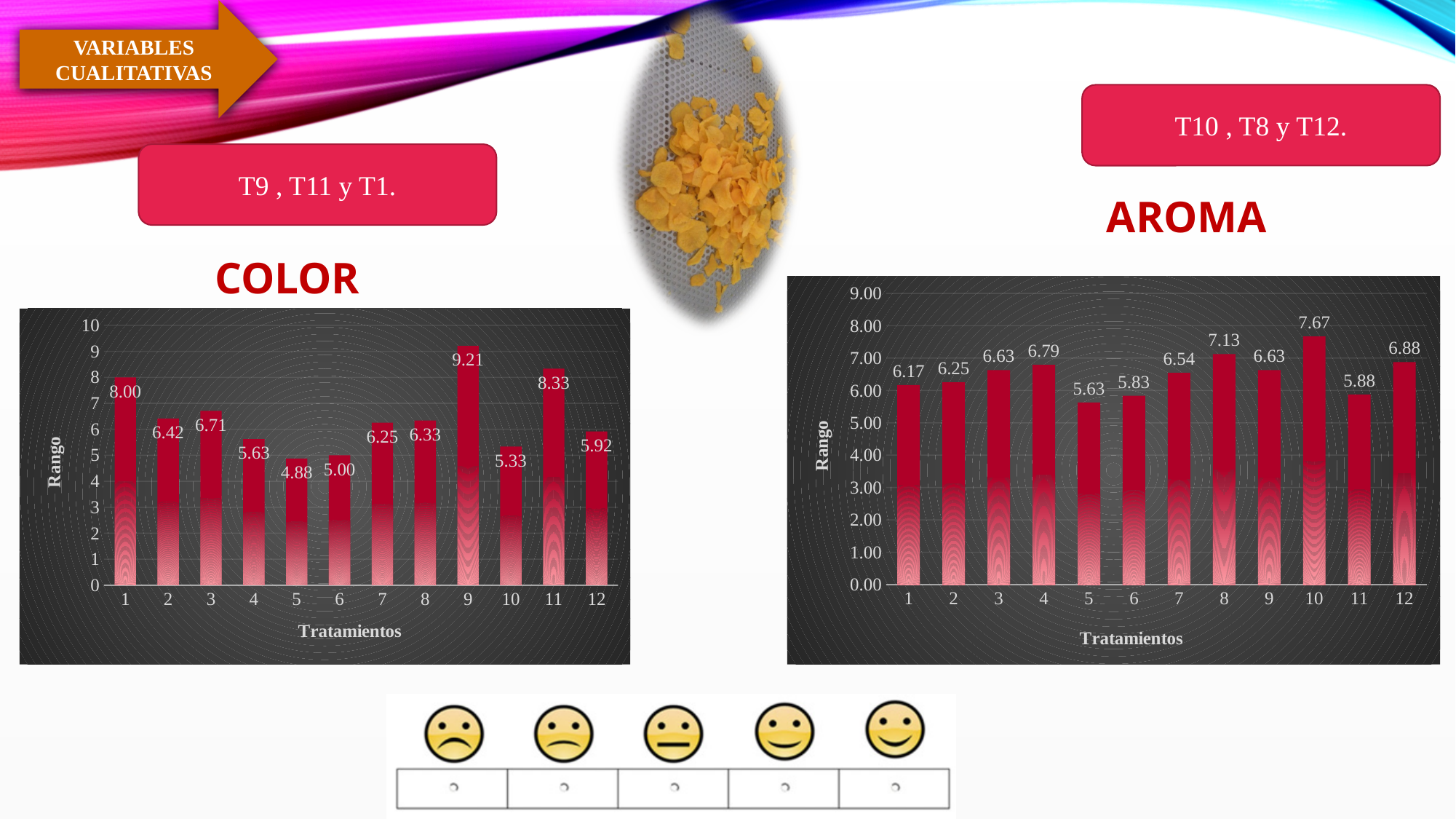
What kind of chart is the AROMA chart? Bar chart In the COLOR chart, which treatment has the lowest value? 5 In the AROMA chart, what is the difference between the values for treatment 8 and treatment 12? 0.25 In the COLOR chart, which is larger, the value for treatment 1 or treatment 11? Treatment 11 In the COLOR chart, what is the difference between the values for treatment 9 and treatment 11? 0.88 In the COLOR chart, what is the value for treatment 9? 9.21 In the AROMA chart, what is the value for treatment 10? 7.67 In the AROMA chart, which treatment has the lowest value? 5 In the AROMA chart, which is larger, the value for treatment 4 or treatment 7? Treatment 4 How many treatments are shown on the x axis of the COLOR chart? 12 In the AROMA chart, which treatment has the highest value? 10 What is the y-axis label of the COLOR chart? Rango